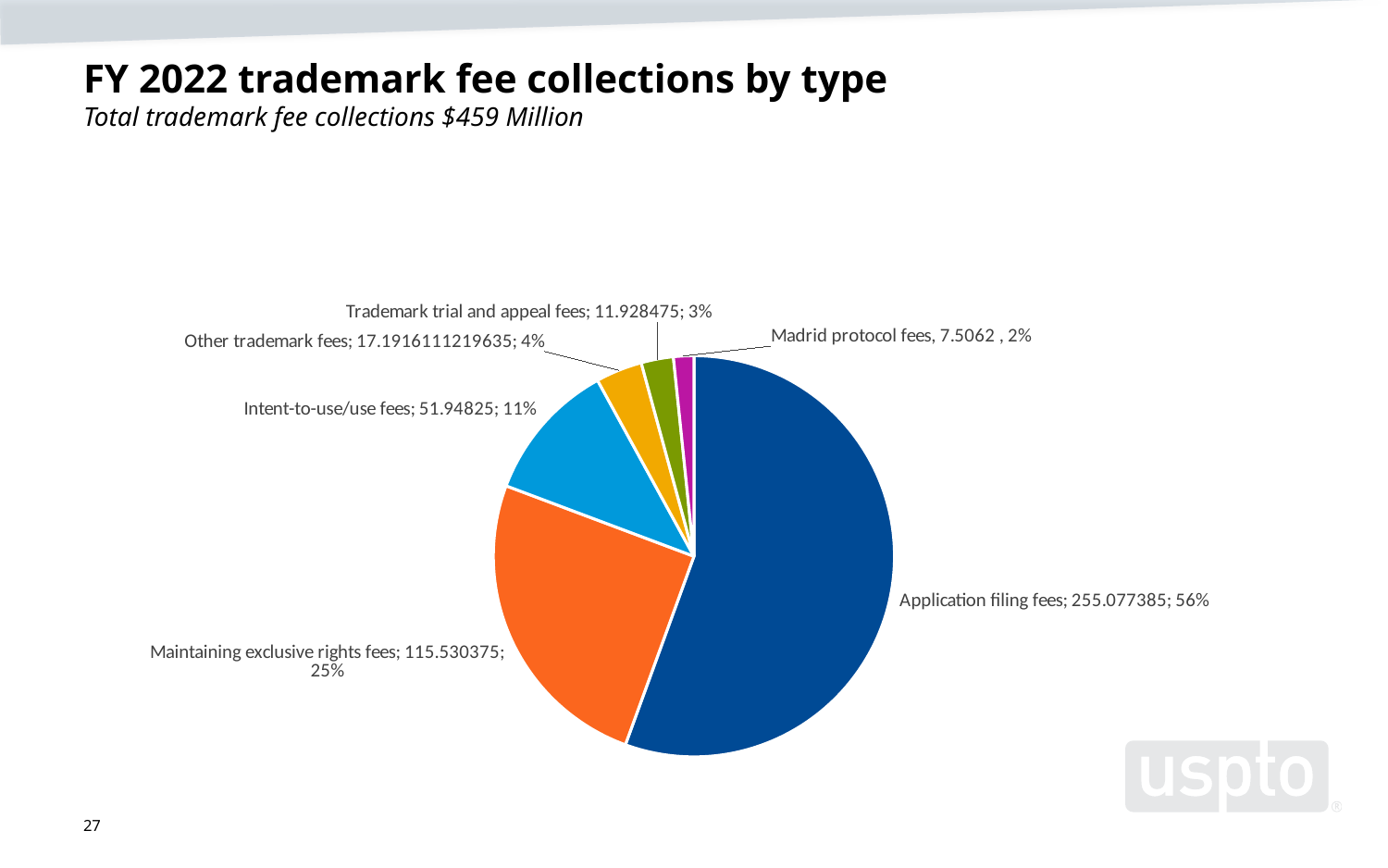
How many slices does the pie chart have? 6 What is the value shown for Application filing fees? 255.077385 Which fee type has the largest slice of the pie? Application filing fees What is the value shown for Intent-to-use/use fees? 51.94825 What is the value shown for Maintaining exclusive rights fees? 115.530375 What is the value shown for Madrid protocol fees? 7.5062 What share of the pie do Maintaining exclusive rights fees represent? 25% What share of the pie do Trademark trial and appeal fees represent? 3% What type of chart is shown on the slide? Pie chart Which fee type has the smallest slice of the pie? Madrid protocol fees Which is larger, Other trademark fees or Intent-to-use/use fees? Intent-to-use/use fees What is the title of the chart on the slide? FY 2022 trademark fee collections by type